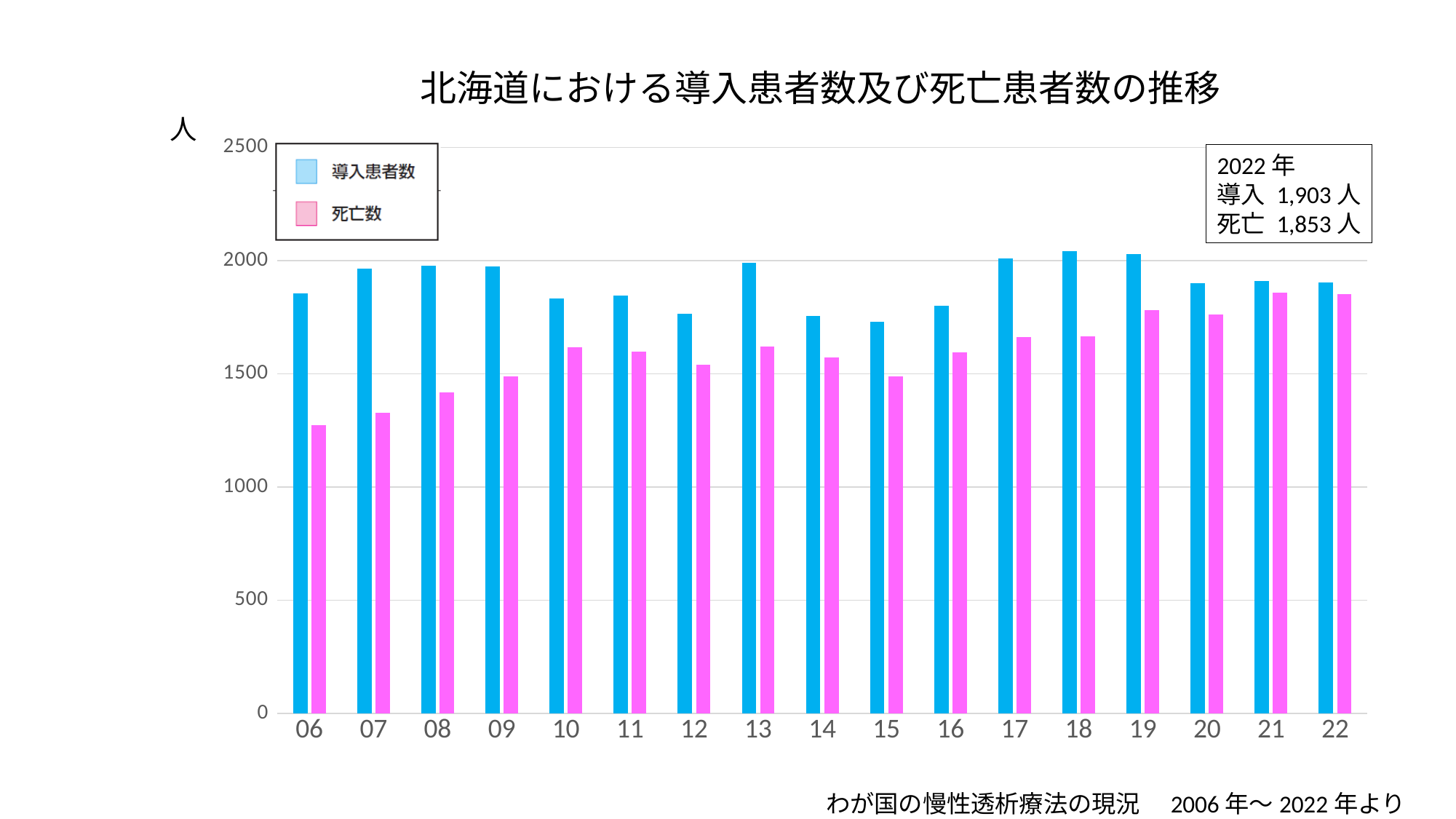
Is the 導入患者数 value for 18 greater or less than 2000? greater Does the 死亡数 series generally rise or fall from 06 to 22? rise How many series does the legend list? 2 What colour are the 死亡数 bars? pink What is the difference between the 導入 and 死亡 values for 2022? 50 人 What kind of chart is shown on the slide? bar chart How many years are shown on the x axis? 17 What is the 導入 (導入患者数) value for 2022 according to the annotation box? 1,903 人 In 06, which is larger, 導入患者数 or 死亡数? 導入患者数 Which year has the lowest 死亡数 value? 06 Is the 死亡数 value for 06 greater or less than 1500? less What is the 死亡 (死亡数) value for 2022 according to the annotation box? 1,853 人